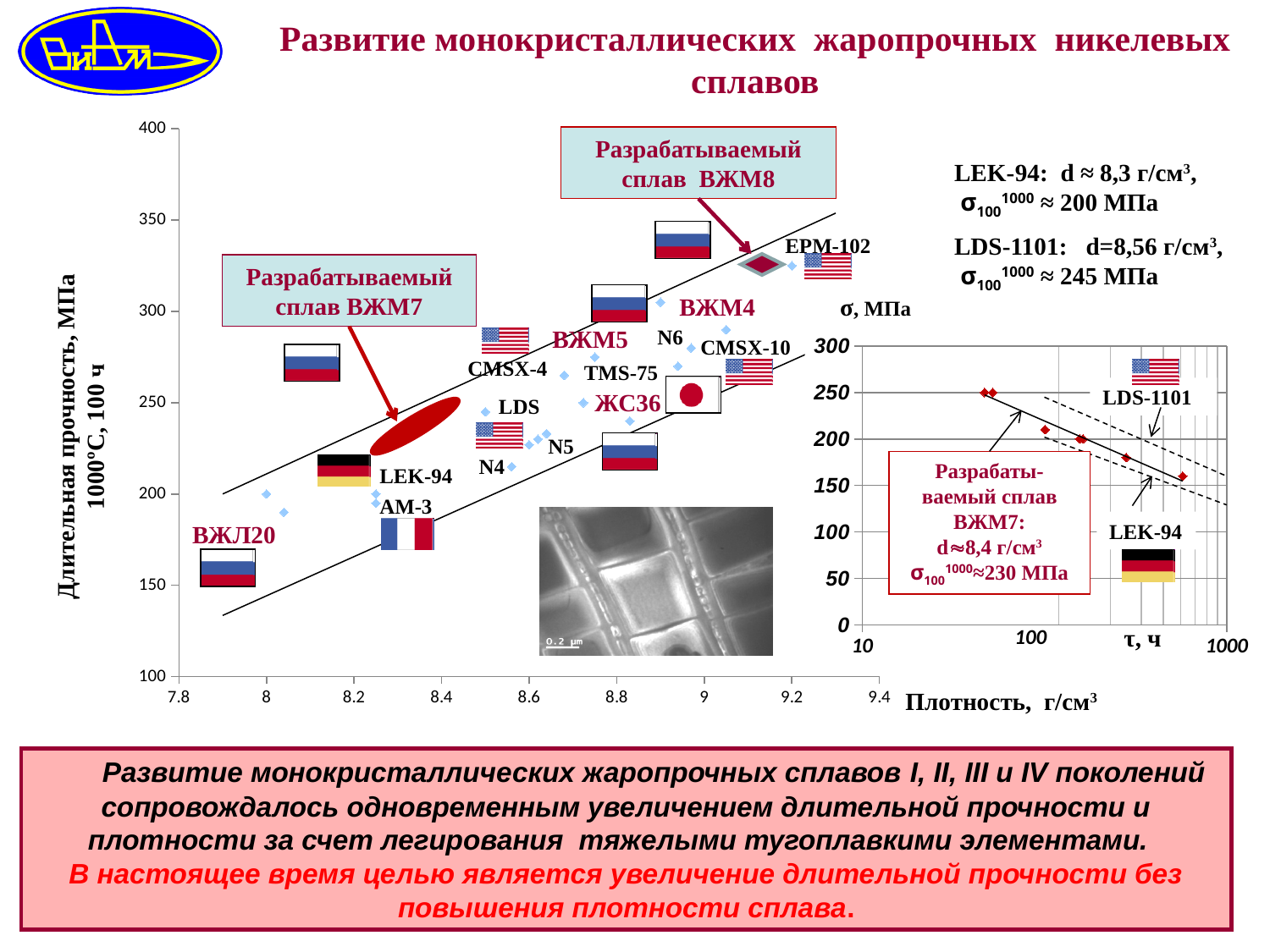
On the small inset chart on the right (σ vs τ), what is the largest value shown on the horizontal axis? 1000 On the large chart on the left, what is the label of the horizontal axis? Плотность, г/см³ On the small inset chart on the right (σ vs τ), do the plotted σ values rise or fall as τ increases along the x axis? fall On the large chart on the left, which alloy has a higher long-term strength, ВЖМ8 or AM-3? ВЖМ8 On the large chart on the left, what is the highest value shown on the vertical axis? 400 How many charts are shown on the slide? 2 On the large chart on the left, what is the lowest value shown on the horizontal axis? 7.8 What kind of chart is the large chart on the left of the slide (density vs. long-term strength)? scatter chart On the large chart on the left, do the plotted long-term strength values generally rise or fall as density increases along the x axis? rise On the large chart on the left, is the long-term strength value for EPM-102 greater or less than 300? greater On the small inset chart on the right (σ vs τ), what is the highest value shown on the vertical axis? 300 On the large chart on the left, is the long-term strength value for ВЖЛ20 greater or less than 250? less